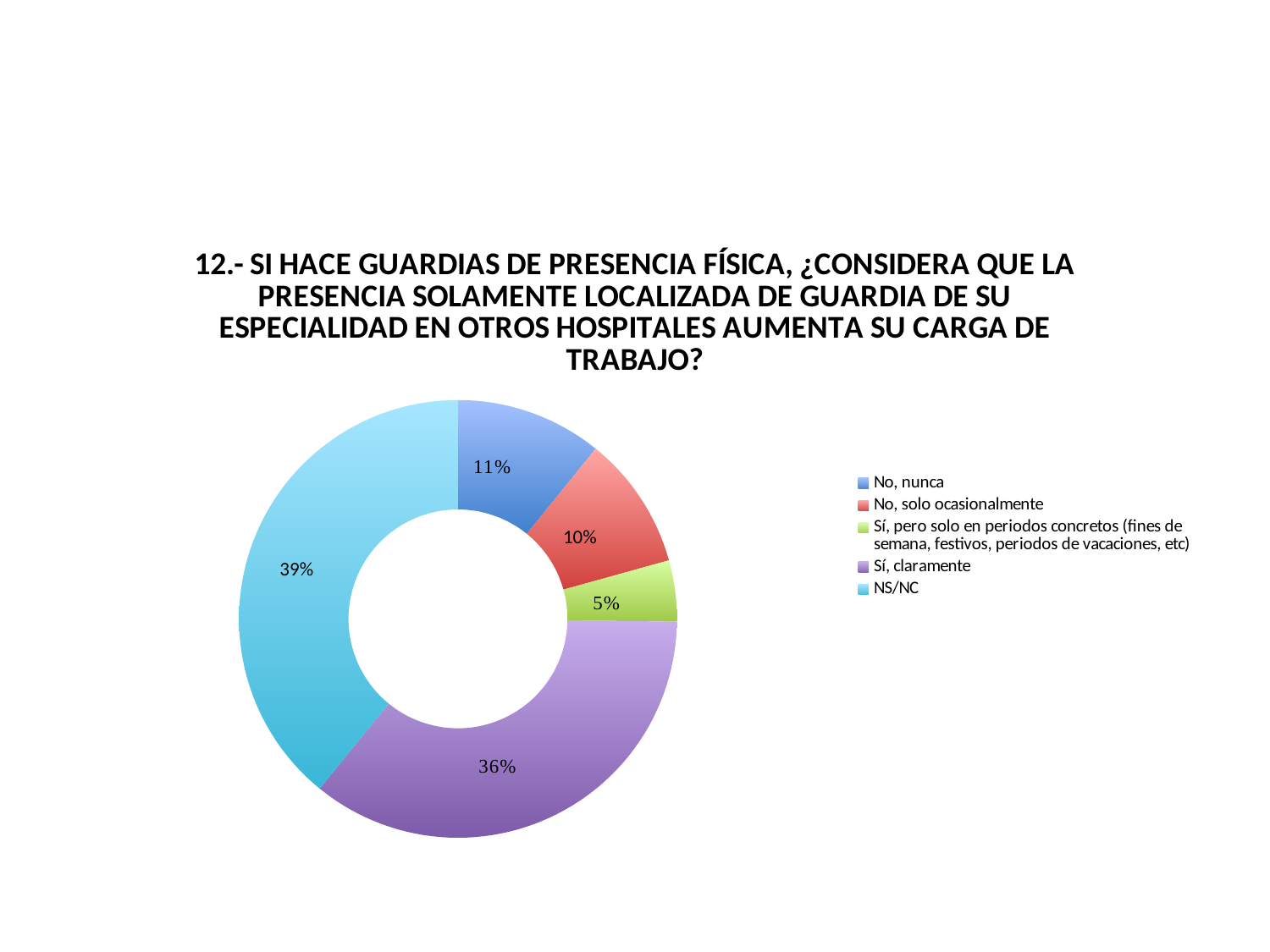
What is the value for "Sí, pero solo en periodos concretos (fines de semana, festivos, periodos de vacaciones, etc)"? 5% What share of the pie does "NS/NC" represent? 39% What share of the pie does "Sí, claramente" represent? 36% Which is larger, the share for "Sí, claramente" or the share for "No, nunca"? Sí, claramente What is the value for "No, solo ocasionalmente"? 10% Which category has the smallest share? Sí, pero solo en periodos concretos (fines de semana, festivos, periodos de vacaciones, etc) How many categories does the chart show? 5 What is the value for "No, nunca"? 11% What is the difference between the shares of "NS/NC" and "Sí, claramente"? 3% Which category has the largest share? NS/NC What kind of chart is shown on the slide? Pie chart (doughnut) What colour is the "Sí, claramente" slice? Purple